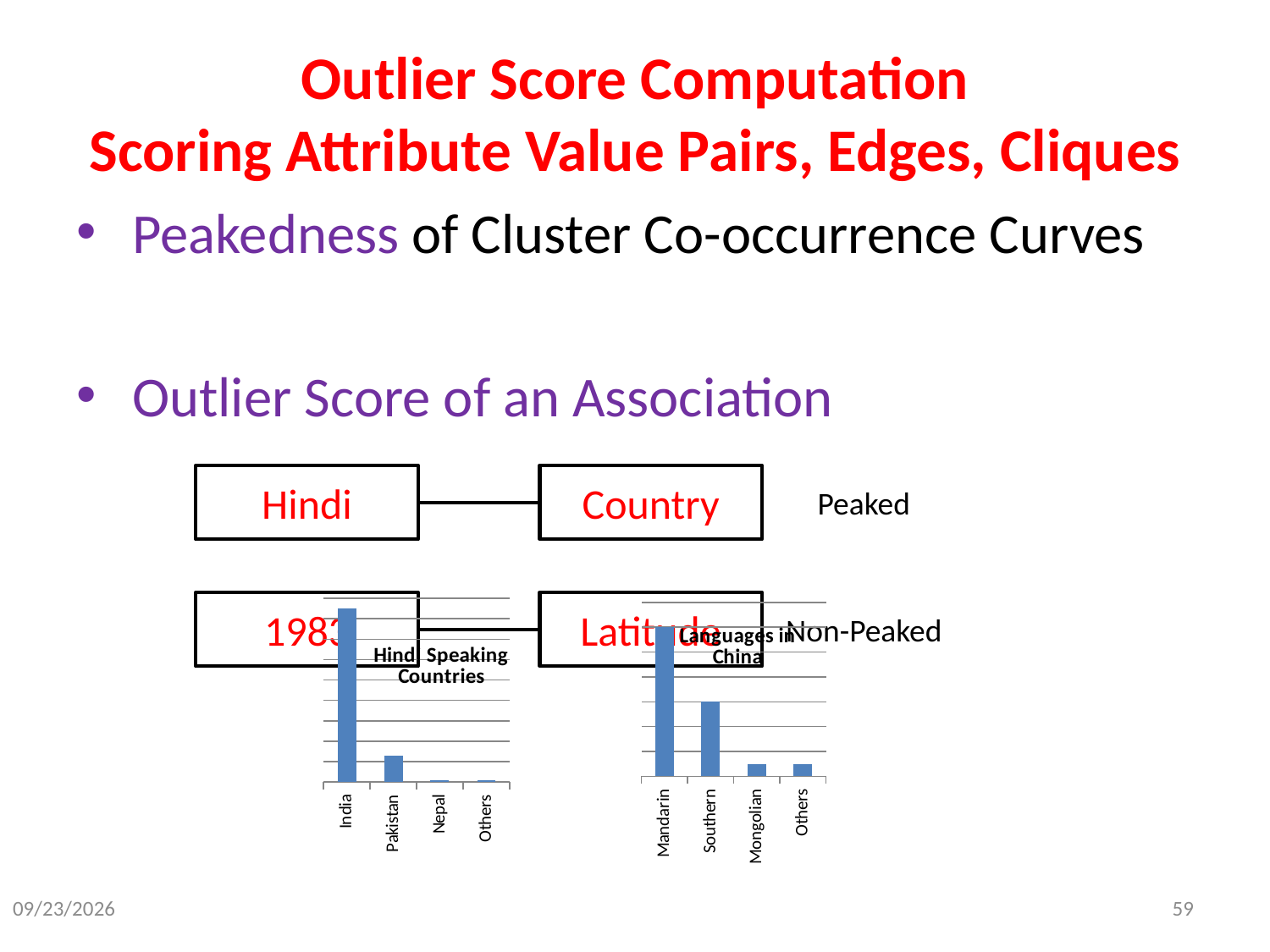
In the 'Languages in China' chart, which is larger, the bar for Mandarin or the bar for Southern? Mandarin How many categories are shown in the 'Hindi Speaking Countries' chart? 4 In the 'Languages in China' chart, which is larger, the bar for Southern or the bar for Mongolian? Southern In the 'Hindi Speaking Countries' chart, do the bar heights rise or fall from India to Others along the x axis? Fall What is the title of the right chart on the slide? Languages in China In the 'Languages in China' chart, which category has the highest bar? Mandarin In the 'Hindi Speaking Countries' chart, which category has the highest bar? India How many categories are shown in the 'Languages in China' chart? 4 What kind of chart is the 'Languages in China' chart? Bar chart In the 'Hindi Speaking Countries' chart, which is larger, the bar for India or the bar for Pakistan? India What is the title of the left chart on the slide? Hindi Speaking Countries